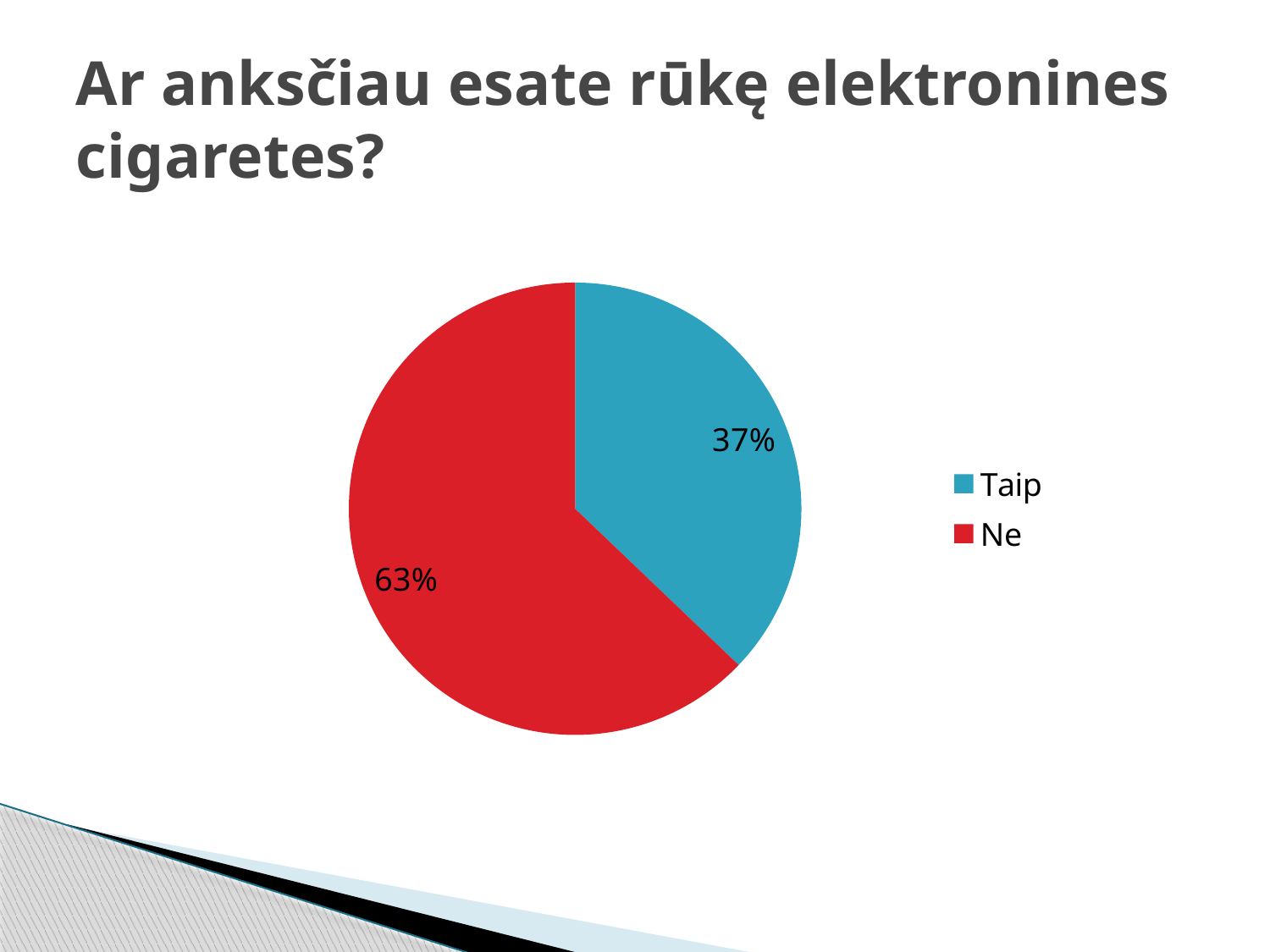
Which is larger, the "Taip" slice or the "Ne" slice? Ne What colour is the "Ne" slice? red What kind of chart is shown on the slide? pie chart Which slice is the smallest? Taip What share of the pie does "Ne" represent? 63% How many entries does the legend list? 2 What share of the pie does "Taip" represent? 37% What is the difference in percentage points between the "Ne" and "Taip" slices? 26 How many slices does the pie chart have? 2 What colour is the "Taip" slice? blue Which slice is the largest? Ne